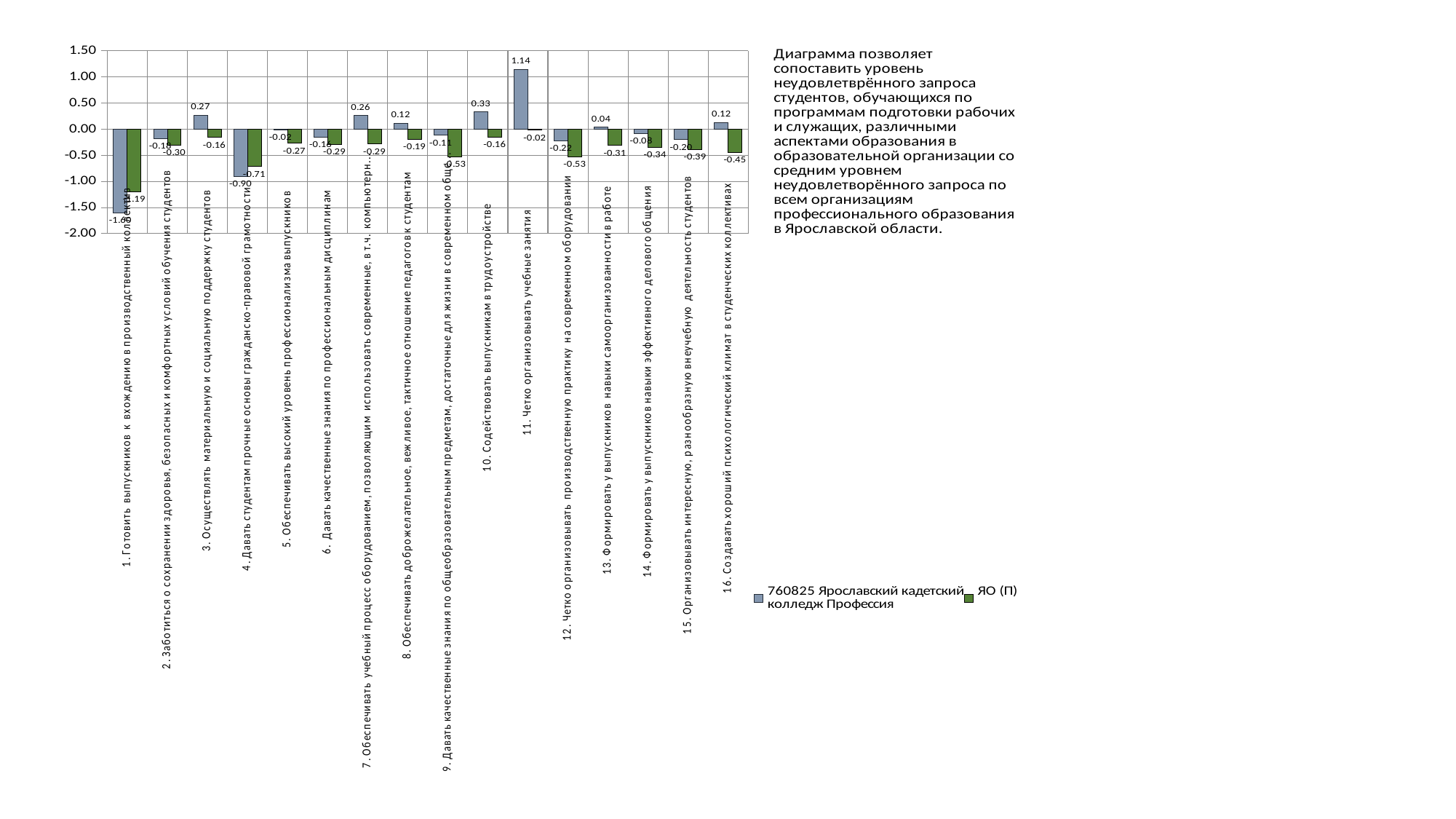
What is the value for '760825 Ярославский кадетский колледж Профессия' in category 4 (Давать студентам прочные основы гражданско-правовой грамотности)? -0.90 What is the difference between the two series in category 16 (Создавать хороший психологический климат в студенческих коллективах)? 0.57 How many categories are plotted along the x axis? 16 How many series does the legend list? 2 What is the value for '760825 Ярославский кадетский колледж Профессия' in category 11 (Четко организовывать учебные занятия)? 1.14 What kind of chart is shown on the slide? bar chart In which category does the '760825 Ярославский кадетский колледж Профессия' series reach its highest value? 11. Четко организовывать учебные занятия Is the value for '760825 Ярославский кадетский колледж Профессия' in category 1 greater or less than -1.50? less In category 3 (Осуществлять материальную и социальную поддержку студентов), which series has the larger value? 760825 Ярославский кадетский колледж Профессия What is the value for 'ЯО (П)' in category 12 (Четко организовывать производственную практику на современном оборудовании)? -0.53 What is the name of the second series in the legend? ЯО (П) In which category does the 'ЯО (П)' series have its lowest value? 1. Готовить выпускников к вхождению в производственный коллектив